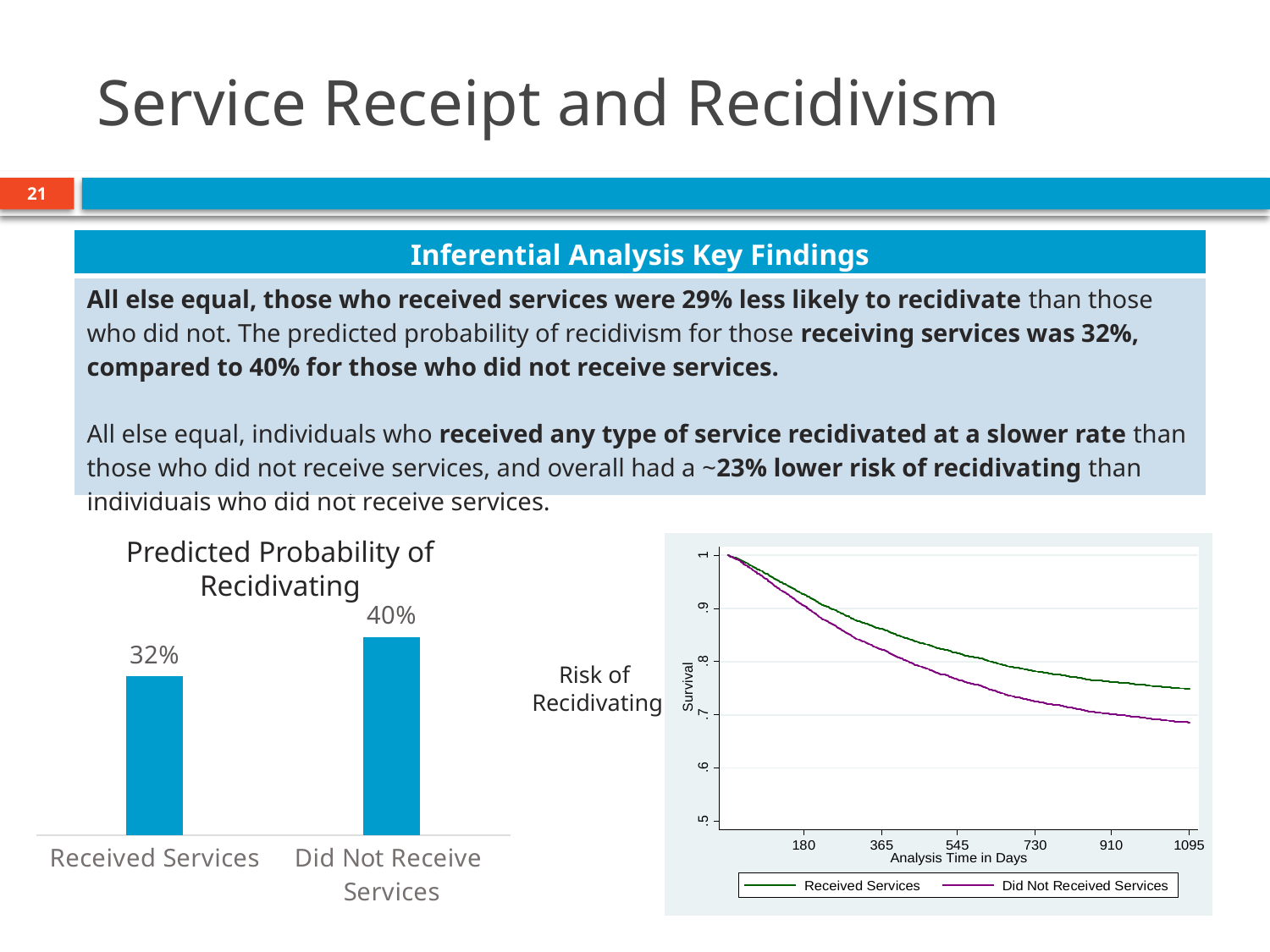
In the Risk of Recidivating chart, how many series does the legend list? 2 In the Risk of Recidivating chart, do the survival values rise or fall as analysis time in days increases? Fall In the Predicted Probability of Recidivating bar chart, what is the difference between the Did Not Receive Services and Received Services values? 8% What kind of chart is the Predicted Probability of Recidivating chart? Bar chart In the Risk of Recidivating chart, what is the label of the x axis? Analysis Time in Days In the Predicted Probability of Recidivating bar chart, how many categories are shown? 2 In the Predicted Probability of Recidivating bar chart, what is the value for Did Not Receive Services? 40% In the Predicted Probability of Recidivating bar chart, which category has the highest value? Did Not Receive Services In the Risk of Recidivating chart, which series has the higher survival value at 1095 days, Received Services or Did Not Received Services? Received Services In the Predicted Probability of Recidivating bar chart, which category has the lowest value? Received Services In the Risk of Recidivating chart, is the Received Services survival value at 1095 days greater or less than .7? greater In the Predicted Probability of Recidivating bar chart, what is the value for Received Services? 32%